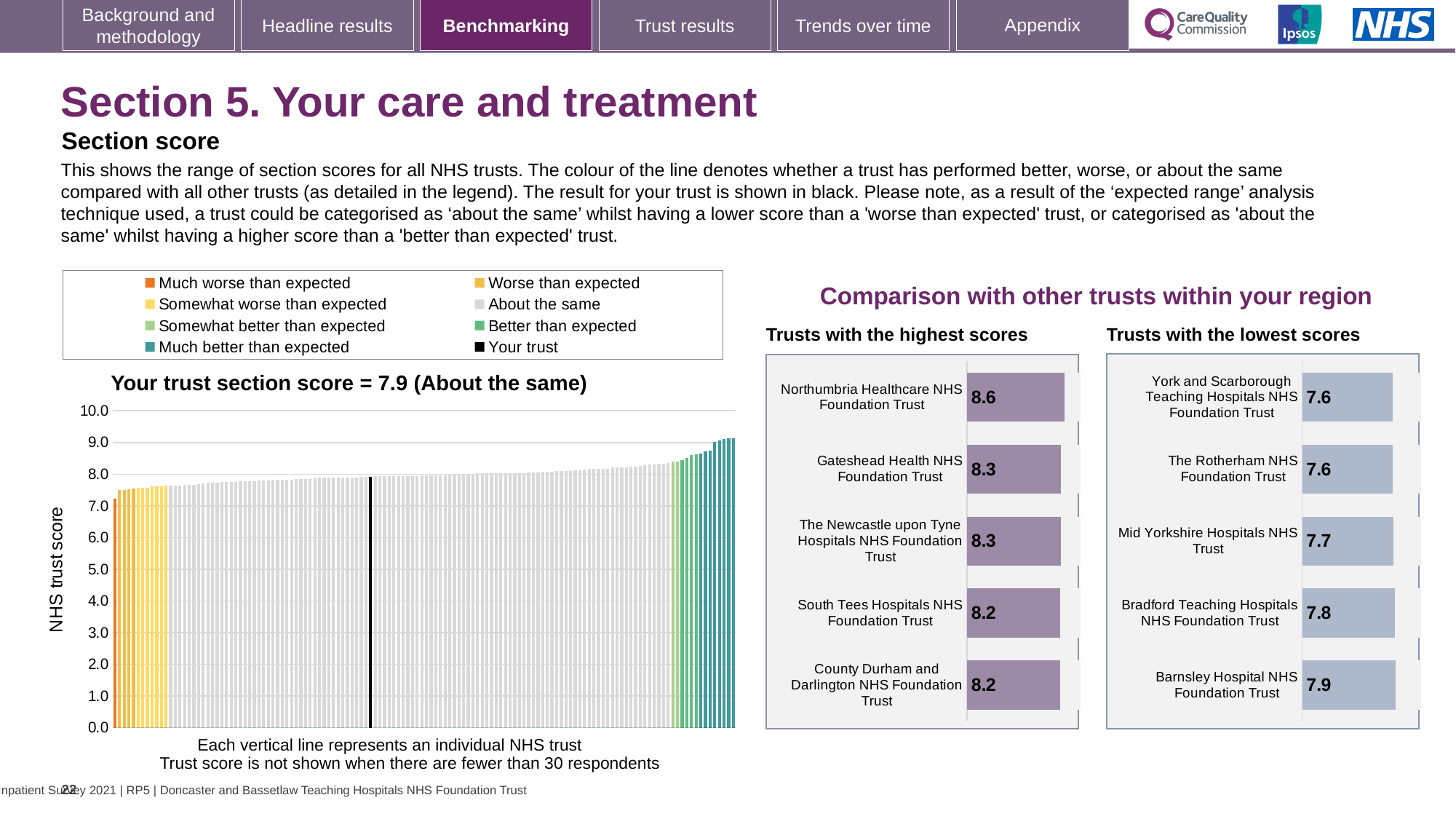
What kind of chart is the large chart on the left showing the range of section scores for all NHS trusts? Bar chart In the 'Trusts with the lowest scores' chart, what is the score for Mid Yorkshire Hospitals NHS Trust? 7.7 In the 'Trusts with the highest scores' chart, which trust has the highest score? Northumbria Healthcare NHS Foundation Trust In the 'Trusts with the highest scores' chart, what is the score for South Tees Hospitals NHS Foundation Trust? 8.2 In the large chart on the left, do the trust scores rise or fall from left to right along the x axis? Rise In the large chart on the left showing all NHS trusts, what is the section score for 'Your trust'? 7.9 In the 'Trusts with the lowest scores' chart, what is the difference between the scores of Barnsley Hospital NHS Foundation Trust and The Rotherham NHS Foundation Trust? 0.3 In the 'Trusts with the lowest scores' chart, which has the larger score: Bradford Teaching Hospitals NHS Foundation Trust or Mid Yorkshire Hospitals NHS Trust? Bradford Teaching Hospitals NHS Foundation Trust In the 'Trusts with the lowest scores' chart, which trust has the highest score? Barnsley Hospital NHS Foundation Trust How many trusts are shown in the 'Trusts with the highest scores' chart? 5 In the 'Trusts with the highest scores' chart, what is the score for Northumbria Healthcare NHS Foundation Trust? 8.6 In the 'Trusts with the highest scores' chart, what is the difference between the scores of Northumbria Healthcare NHS Foundation Trust and County Durham and Darlington NHS Foundation Trust? 0.4